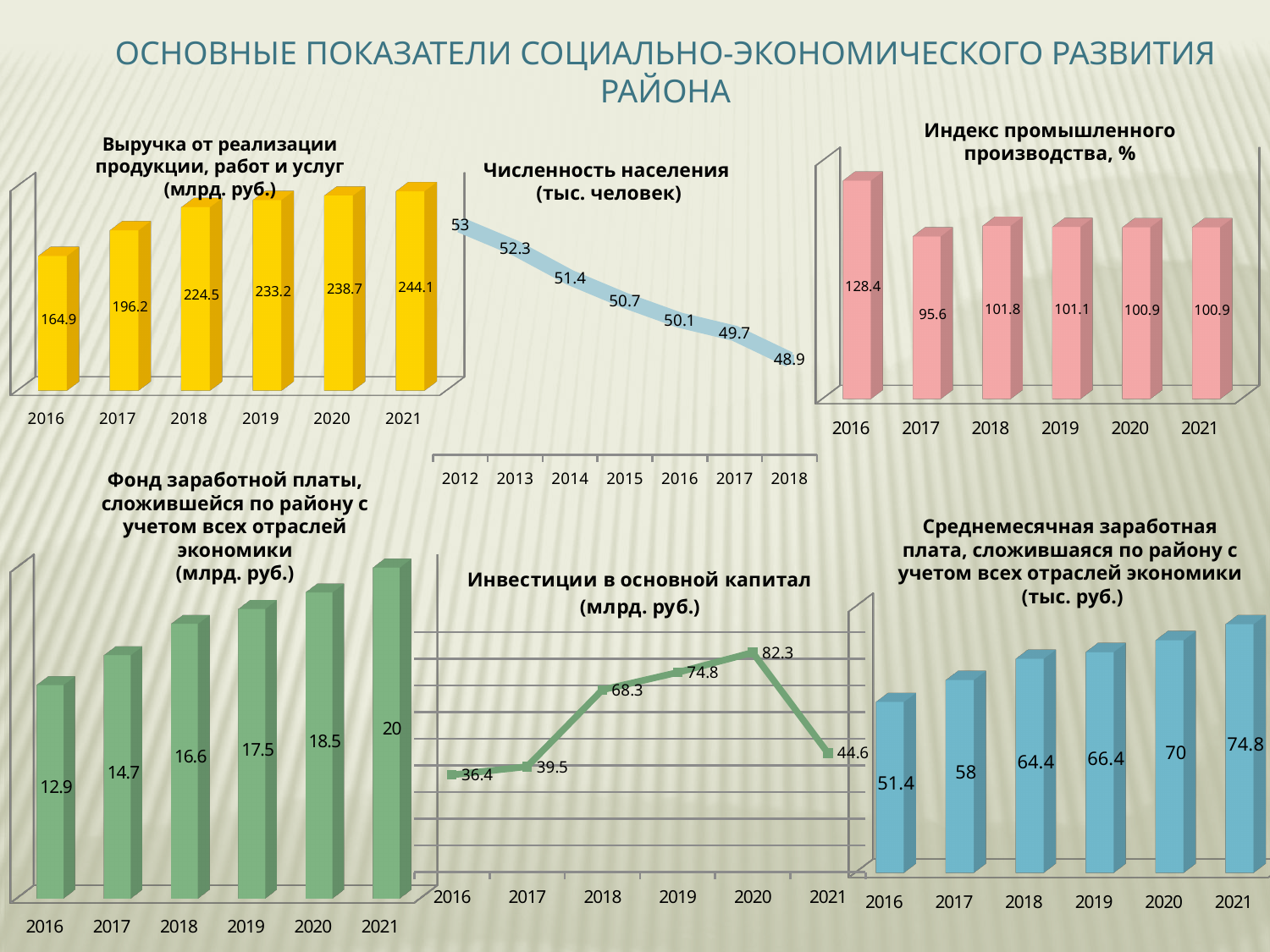
In the chart 'Индекс промышленного производства, %', what is the difference between the values for 2016 and 2017? 32.8 What kind of chart is 'Инвестиции в основной капитал (млрд. руб.)'? line chart In the chart 'Выручка от реализации продукции, работ и услуг (млрд. руб.)', what is the value for 2018? 224.5 In the chart 'Фонд заработной платы, сложившейся по району с учетом всех отраслей экономики (млрд. руб.)', what is the value for 2021? 20 In the chart 'Среднемесячная заработная плата, сложившаяся по району с учетом всех отраслей экономики (тыс. руб.)', which is larger, the value for 2017 or the value for 2019? 2019 How many years are shown in the chart 'Фонд заработной платы, сложившейся по району с учетом всех отраслей экономики (млрд. руб.)'? 6 In the chart 'Индекс промышленного производства, %', which year has the highest value? 2016 In the chart 'Численность населения (тыс. человек)', what is the value for 2015? 50.7 In the chart 'Инвестиции в основной капитал (млрд. руб.)', which year has the highest value? 2020 In the chart 'Численность населения (тыс. человек)', do the values rise or fall from 2012 to 2018? fall In the chart 'Выручка от реализации продукции, работ и услуг (млрд. руб.)', which year has the lowest value? 2016 In the chart 'Среднемесячная заработная плата, сложившаяся по району с учетом всех отраслей экономики (тыс. руб.)', what is the difference between the values for 2021 and 2016? 23.4